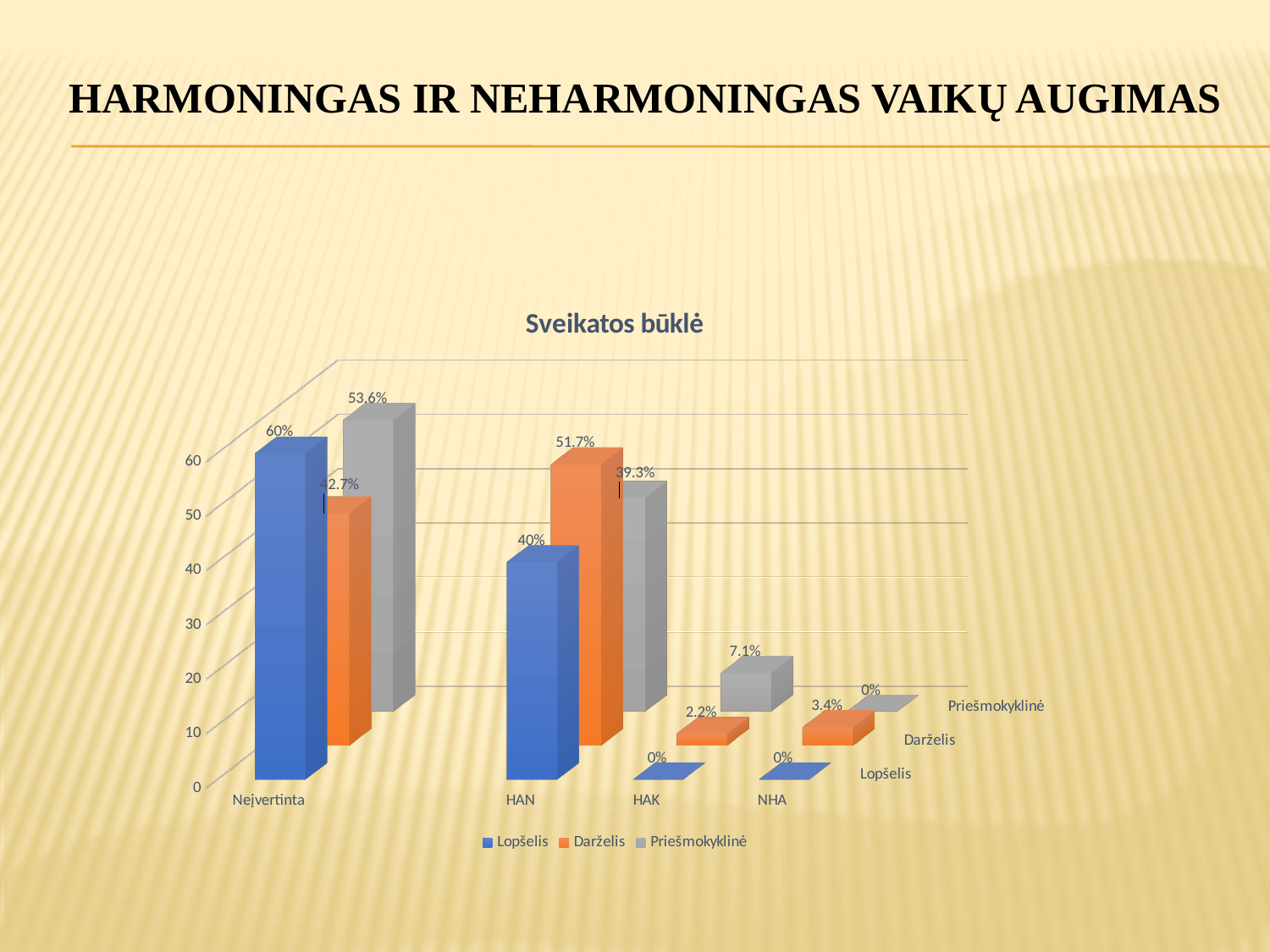
What is the value for Darželis in the HAN category? 51.7% How many series does the legend list? 3 What is the title of the chart? Sveikatos būklė What is the value for Priešmokyklinė in the HAK category? 7.1% Which category has the lowest value for the Priešmokyklinė series? NHA Which category has the highest value for the Darželis series? HAN Which is larger in the HAN category: the Lopšelis value or the Darželis value? Darželis What is the difference between the Lopšelis and Darželis values in the Neįvertinta category? 17.3% How many categories are shown on the x axis? 4 What is the value for Darželis in the NHA category? 3.4% What is the value for Lopšelis in the Neįvertinta category? 60% What kind of chart is shown on the slide? Bar chart